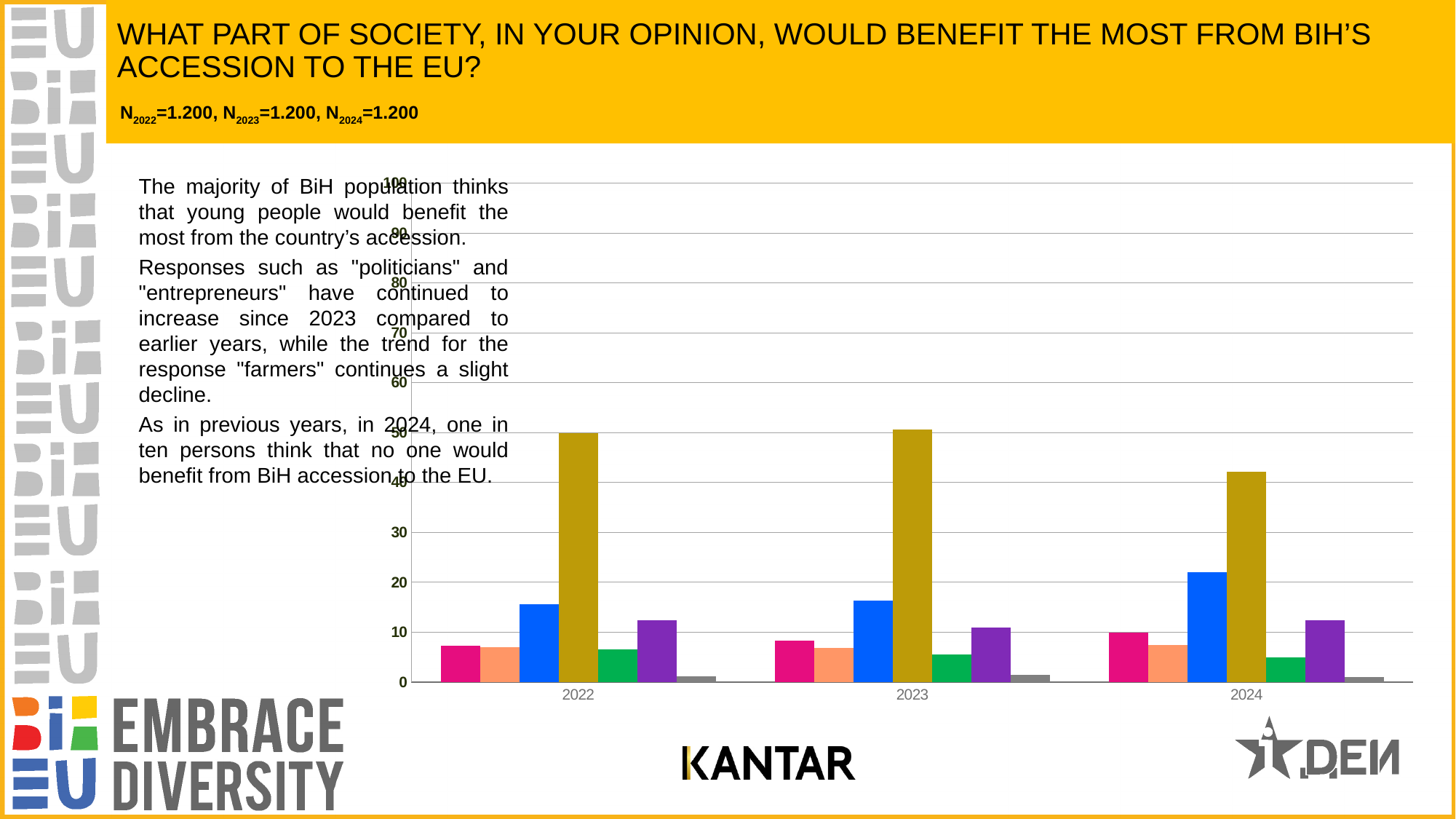
Is the value of the gold bar for 2022 greater or less than 40? greater How many years are shown on the x axis of the chart? 3 Which year has the tallest gold bar? 2023 Is the value of the blue bar for 2022 greater or less than 20? less Which year has the tallest blue bar? 2024 Is the value of the green bar for 2024 greater or less than 10? less What kind of chart is shown on the slide? bar chart Do the gold bars rise or fall from 2022 to 2024? fall How many bars are plotted for the year 2024? 7 Is the blue bar larger in 2022 or in 2024? 2024